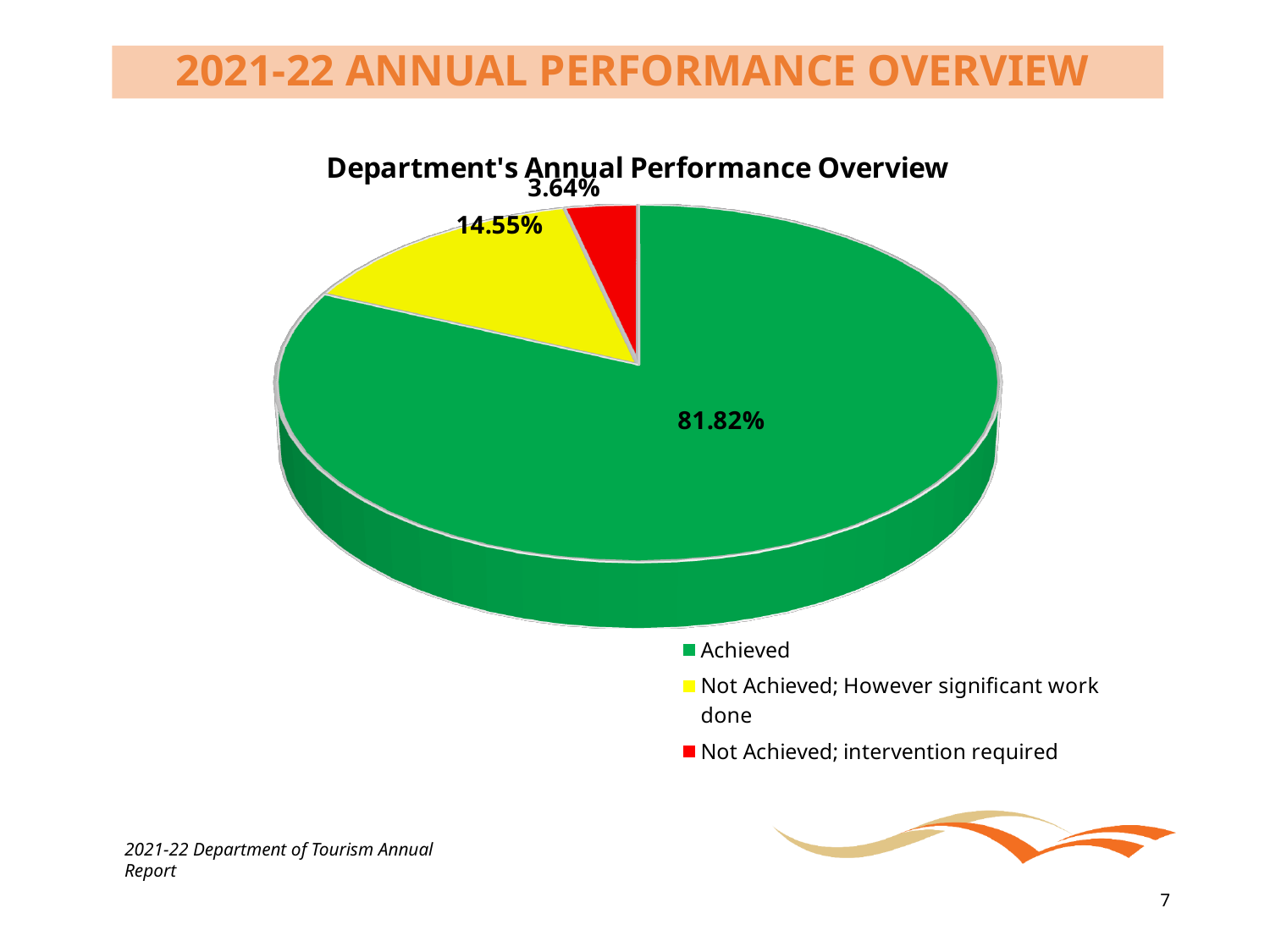
How many entries does the legend list? 3 What percentage is shown for 'Not Achieved; intervention required'? 3.64% What colour represents 'Not Achieved; intervention required' in the pie chart? Red Which category has the largest share of the pie? Achieved What is the difference between the 'Achieved' share and the 'Not Achieved; However significant work done' share? 67.27% What type of chart is shown on the slide? Pie chart What is the chart's title? Department's Annual Performance Overview Which is larger: the share for 'Not Achieved; However significant work done' or the share for 'Not Achieved; intervention required'? Not Achieved; However significant work done Which category has the smallest share of the pie? Not Achieved; intervention required How many slices does the pie chart have? 3 What percentage of the pie is labelled 'Achieved'? 81.82% What percentage is shown for 'Not Achieved; However significant work done'? 14.55%